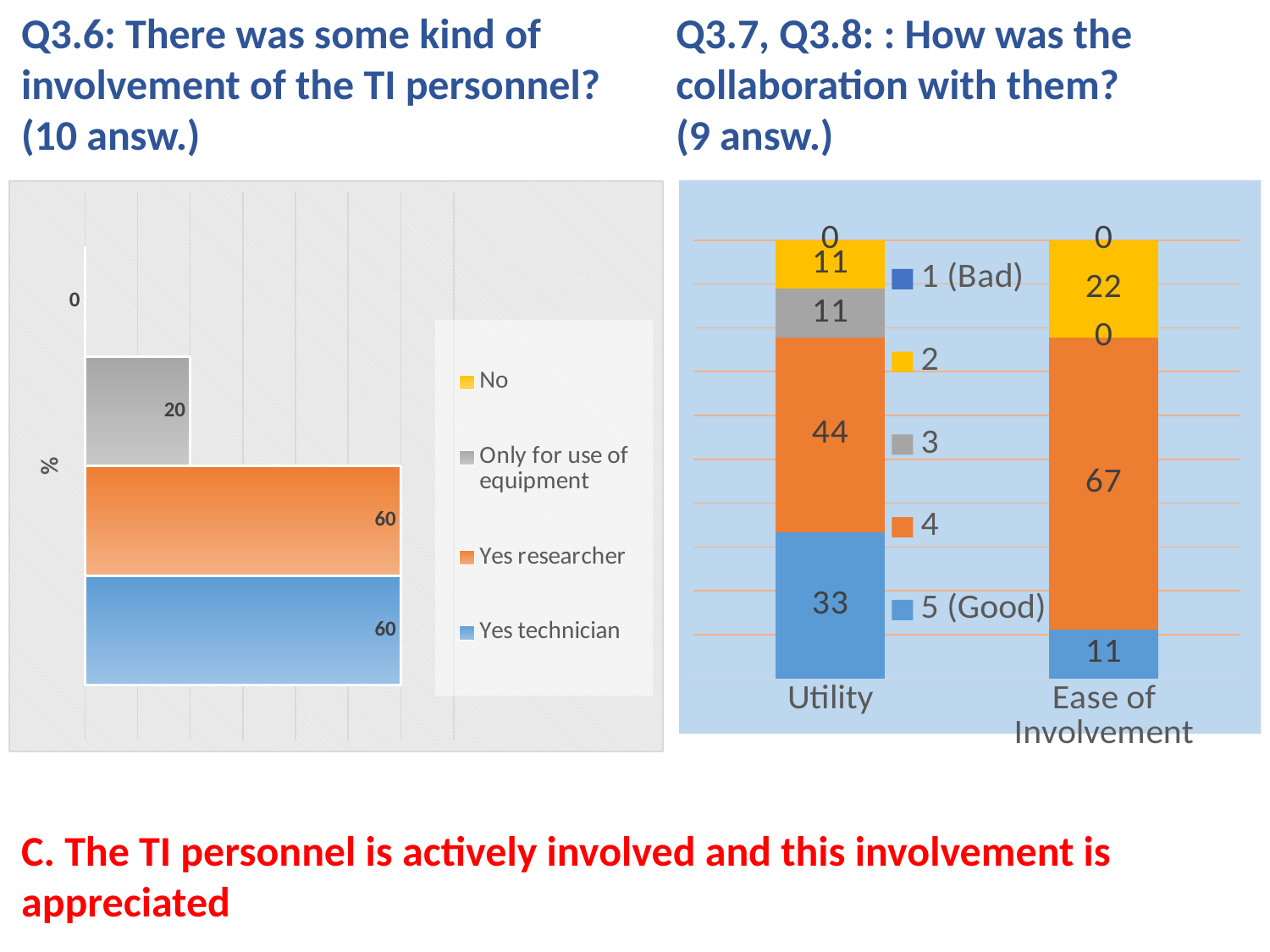
What kind of chart is the left chart (Q3.6)? Bar chart In the left chart (Q3.6), how many entries does the legend list? 4 In the left chart (Q3.6), what is the value for 'Only for use of equipment'? 20 In the right chart (Q3.7, Q3.8), what is the value for rating 4 in the 'Ease of Involvement' bar? 67 In the left chart (Q3.6), what is the difference between 'Yes researcher' and 'Only for use of equipment'? 40 In the right chart (Q3.7, Q3.8), what is the total of the 'Utility' stacked bar? 99 In the right chart (Q3.7, Q3.8), what is the value for '5 (Good)' in the 'Utility' bar? 33 In the right chart (Q3.7, Q3.8), what is the value for rating 2 in the 'Ease of Involvement' bar? 22 In the left chart (Q3.6), what is the value for 'Yes technician'? 60 In the right chart (Q3.7, Q3.8), how many series does the legend list? 5 In the right chart (Q3.7, Q3.8), which is larger: the '5 (Good)' value for 'Utility' or for 'Ease of Involvement'? Utility In the left chart (Q3.6), which category has the lowest value? No